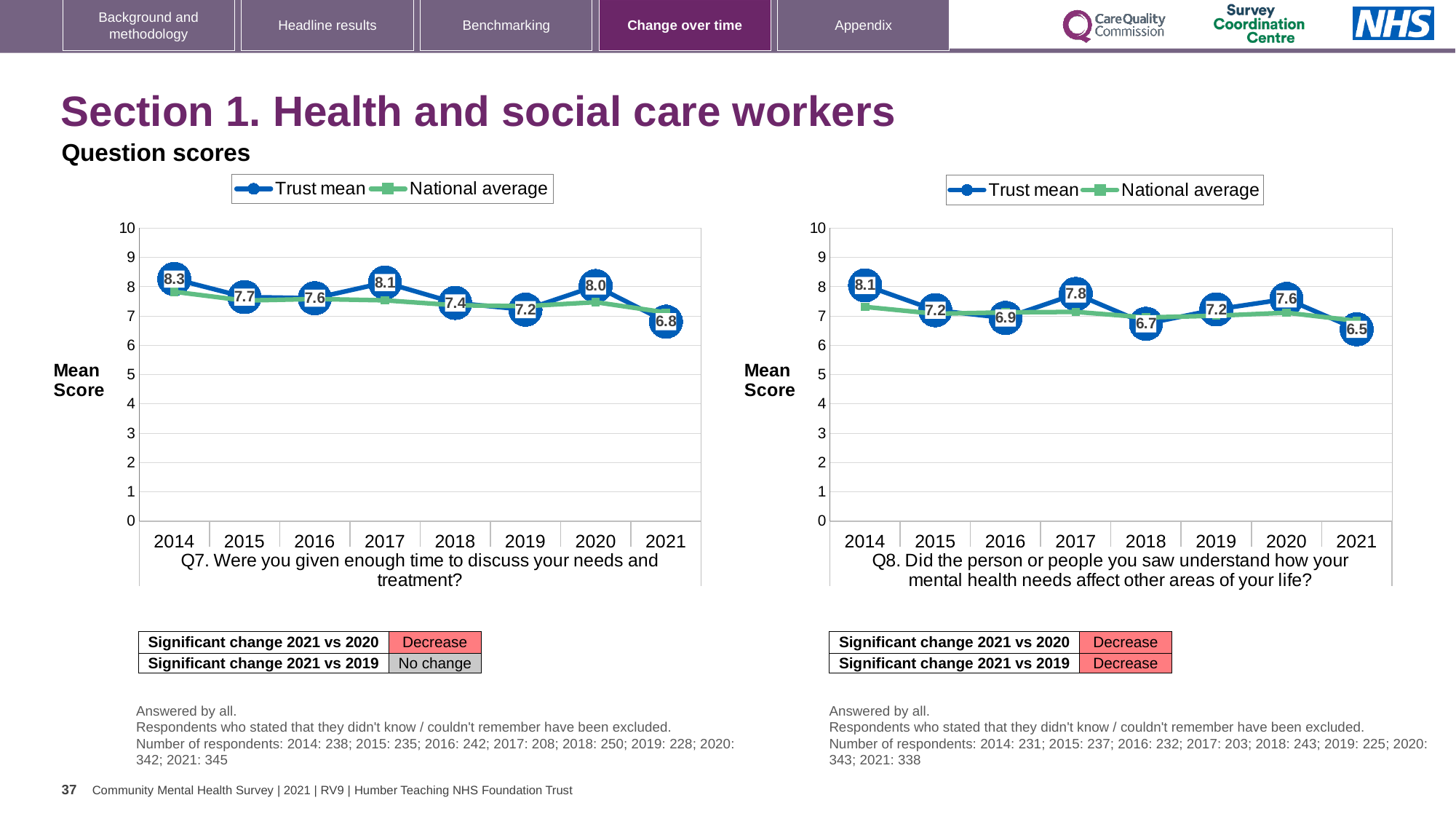
In the Q8 chart (right), what is the Trust mean for 2017? 7.8 In the Q7 chart (left), what is the Trust mean for 2014? 8.3 How many series does the legend of the Q8 chart (right) list? 2 In the Q7 chart (left), which year has the lowest Trust mean? 2021 What kind of chart is the Q7 chart (left)? Line chart In the Q8 chart (right), which year has the lowest Trust mean? 2021 In the Q8 chart (right), is the Trust mean for 2014 or 2018 larger? 2014 In the Q7 chart (left), which year has the highest Trust mean? 2014 In the Q8 chart (right), is the National average for 2021 greater or less than 8? less In the Q7 chart (left), what is the difference between the Trust mean for 2020 and 2021? 1.2 In the Q7 chart (left), what is the Trust mean for 2021? 6.8 How many years are shown on the x axis of the Q7 chart (left)? 8